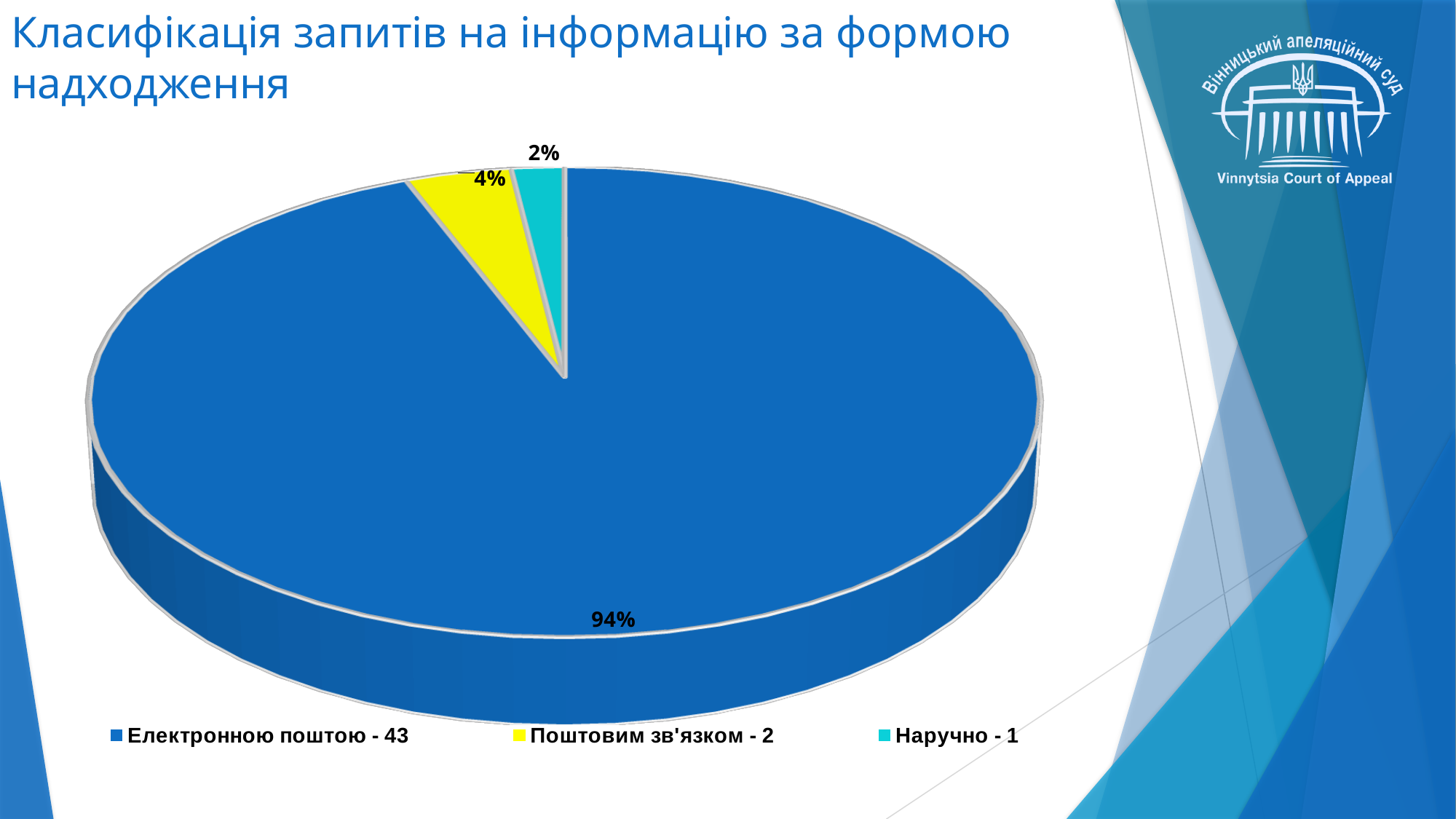
What colour is the slice for 'Поштовим зв'язком - 2'? yellow Which category has the smallest slice of the pie? Наручно - 1 Which slice is larger: 'Поштовим зв'язком - 2' or 'Наручно - 1'? Поштовим зв'язком - 2 What is the title of the slide? Класифікація запитів на інформацію за формою надходження What percentage share does the slice for 'Електронною поштою - 43' have? 94% How many slices does the pie chart have? 3 What is the difference in percentage points between the 'Електронною поштою' slice and the 'Поштовим зв'язком' slice? 90% How many entries does the legend list? 3 What percentage share does the slice for 'Наручно - 1' have? 2% Which category has the largest slice of the pie? Електронною поштою - 43 What kind of chart is shown on the slide? pie chart What percentage share does the slice for 'Поштовим зв'язком - 2' have? 4%